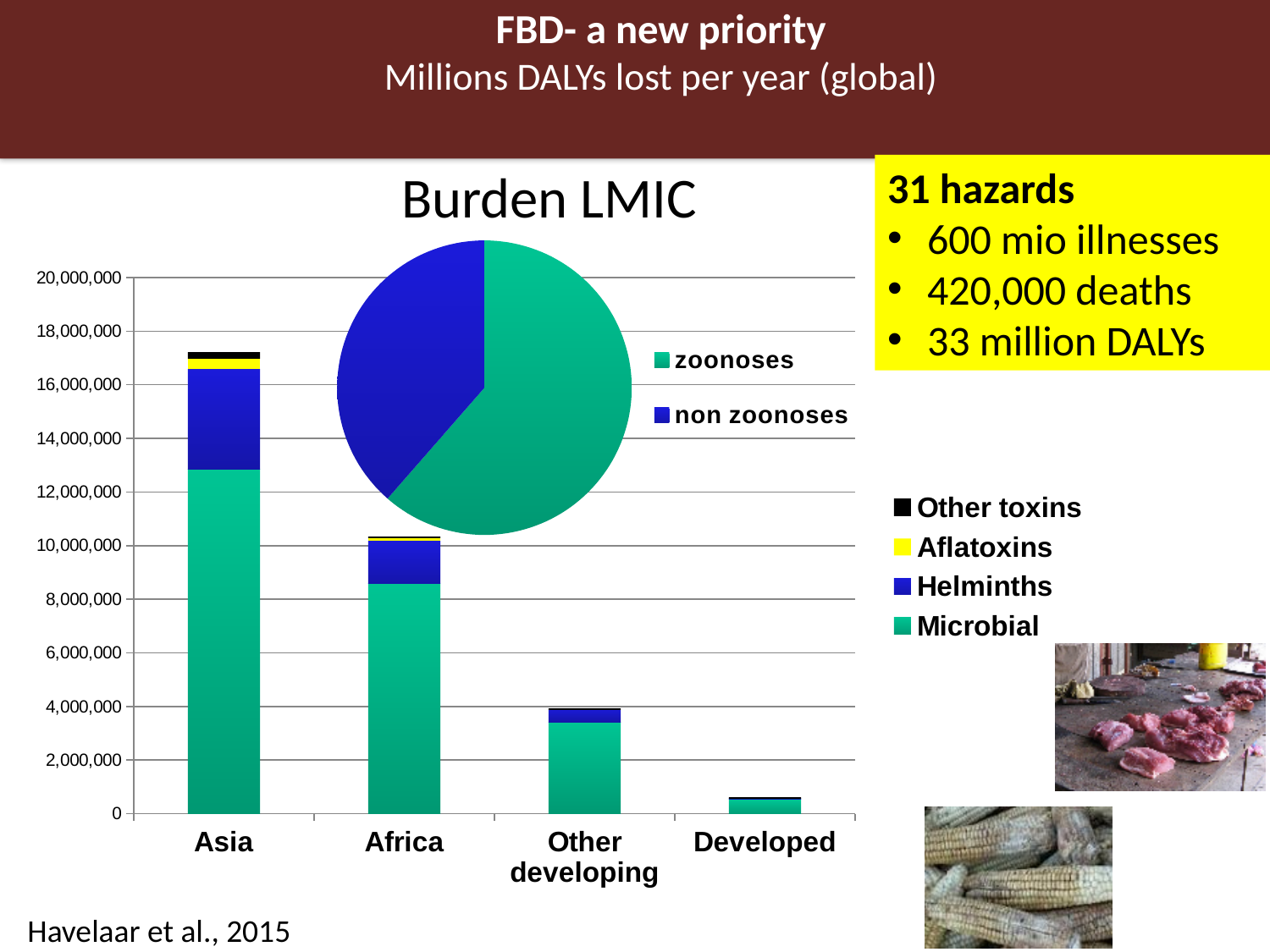
How many series does the legend of the Burden LMIC bar chart list? 4 On the Burden LMIC bar chart, is the total stacked value for Asia greater or less than 16,000,000? greater On the Burden LMIC bar chart, which has the larger total burden, Africa or Other developing? Africa In the pie chart, which slice is larger, zoonoses or non zoonoses? zoonoses How many categories are shown on the x axis of the Burden LMIC bar chart? 4 On the Burden LMIC bar chart, is the total stacked value for Other developing greater or less than 2,000,000? greater On the Burden LMIC bar chart, which category has the tallest stacked bar? Asia What kind of chart is the Burden LMIC chart with the Asia, Africa, Other developing and Developed categories? Stacked bar chart On the Burden LMIC bar chart, is the total stacked value for Developed greater or less than 2,000,000? less Which series in the Burden LMIC bar chart legend is shown in yellow? Aflatoxins On the Burden LMIC bar chart, which category has the shortest stacked bar? Developed